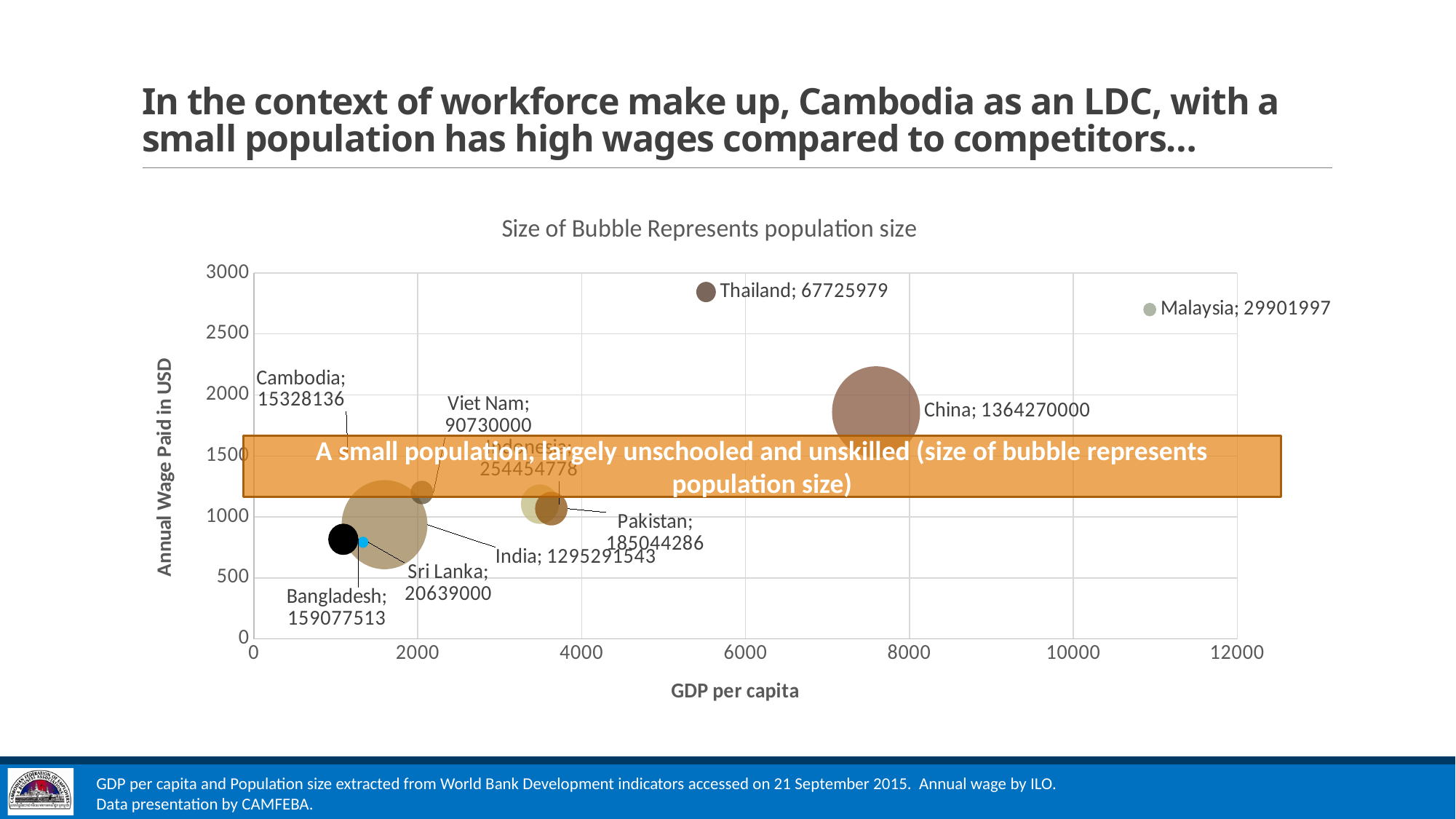
What population size is shown in the data label for China? 1364270000 Is the annual wage for Thailand greater or less than 2500? greater What is the difference between the labelled populations of China and India? 68978457 What is the title of the vertical axis? Annual Wage Paid in USD Which country has the largest population according to the data labels? China Is the GDP per capita for China greater or less than 6000? greater What population size is shown in the data label for Cambodia? 15328136 Which country has the smallest population according to the data labels? Cambodia Is the annual wage for Bangladesh greater or less than 1000? less Which has the larger labelled population, Thailand or Malaysia? Thailand What population size is shown in the data label for Thailand? 67725979 What kind of chart is shown on the slide? Bubble chart